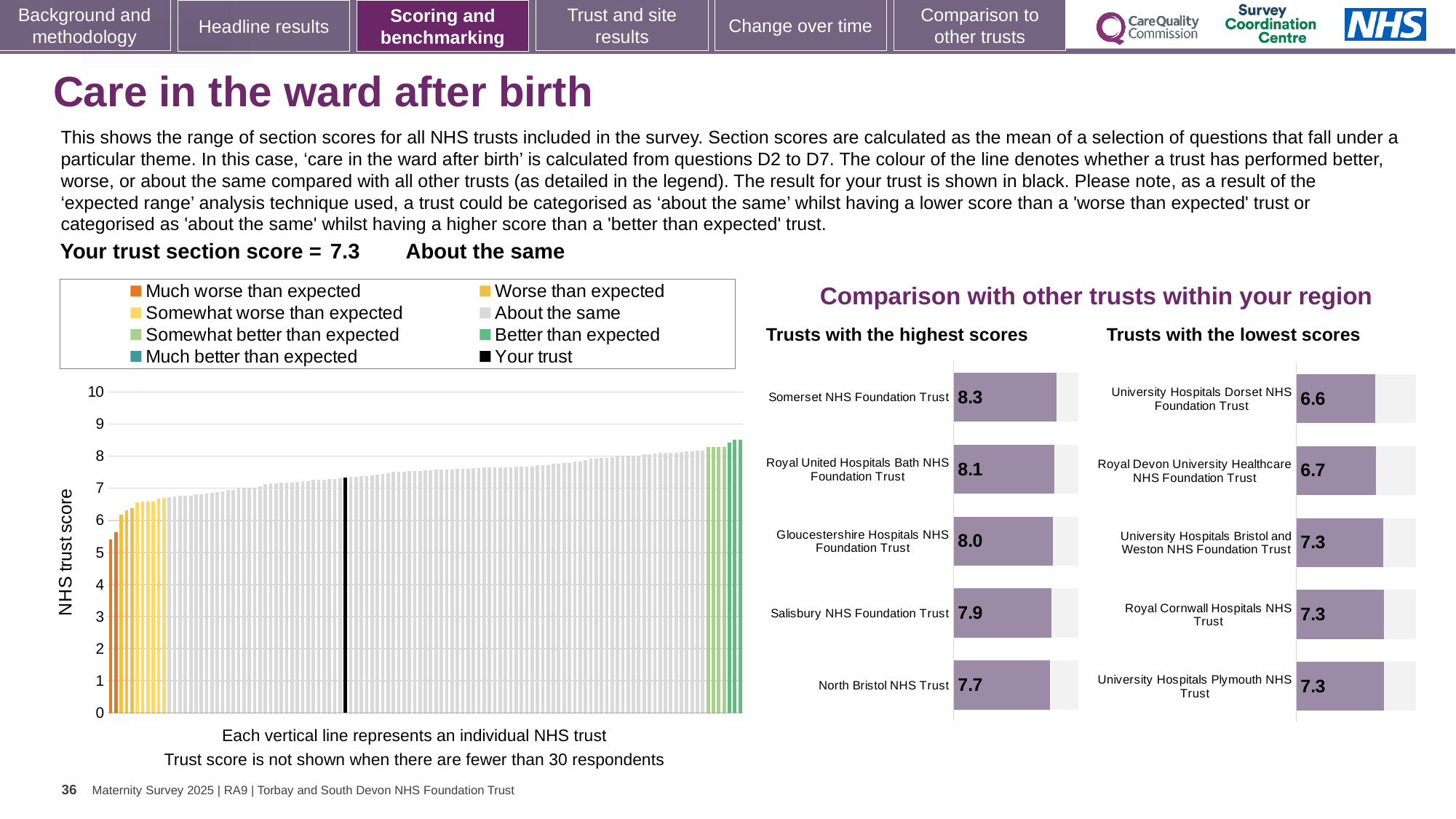
What kind of chart is the main chart with the y-axis labelled 'NHS trust score'? bar chart How many trusts are shown in the 'Trusts with the lowest scores' chart? 5 How many entries does the legend of the main 'NHS trust score' chart list? 8 In the 'Trusts with the highest scores' chart, what is the difference between the scores of Somerset NHS Foundation Trust and North Bristol NHS Trust? 0.6 In the main 'NHS trust score' chart, do the bar values rise or fall from left to right? rise In the 'Trusts with the highest scores' chart, which trust has the highest score? Somerset NHS Foundation Trust In the 'Trusts with the lowest scores' chart, what is the score for University Hospitals Dorset NHS Foundation Trust? 6.6 In the 'Trusts with the highest scores' chart, what is the score for Somerset NHS Foundation Trust? 8.3 In the main 'NHS trust score' chart, is the value for the black 'Your trust' bar greater or less than 7? greater In the 'Trusts with the lowest scores' chart, which trust has the lowest score? University Hospitals Dorset NHS Foundation Trust In the 'Trusts with the highest scores' chart, what is the score for North Bristol NHS Trust? 7.7 In the 'Trusts with the lowest scores' chart, which has the higher score: Royal Devon University Healthcare NHS Foundation Trust or University Hospitals Dorset NHS Foundation Trust? Royal Devon University Healthcare NHS Foundation Trust